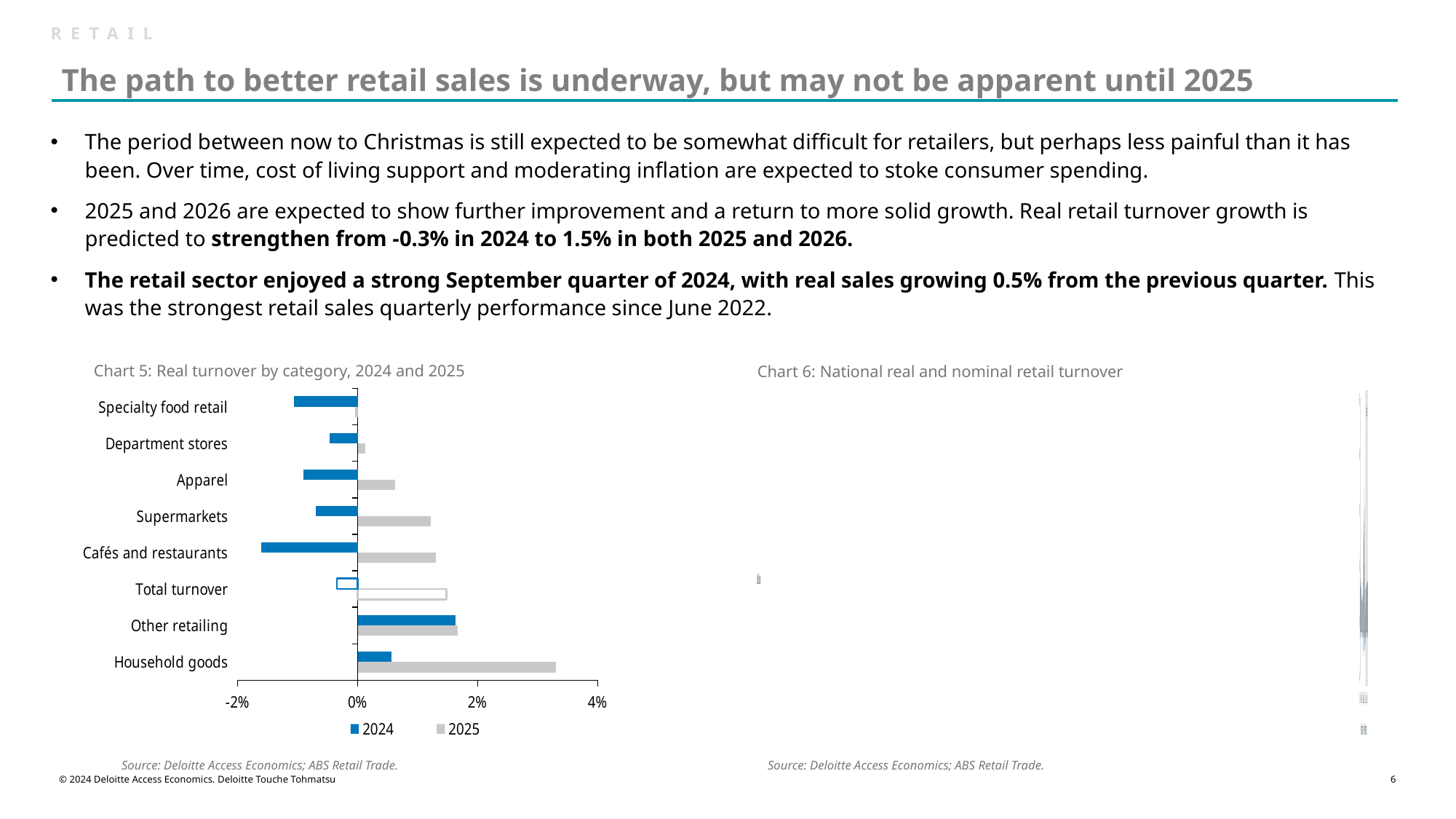
What kind of chart is Chart 5: Real turnover by category, 2024 and 2025? Bar chart In Chart 5, is the 2024 value for Cafés and restaurants greater or less than 0%? less In Chart 5, is the 2025 value for Supermarkets greater or less than 2%? less In Chart 5, which category has the lowest 2024 value? Cafés and restaurants In Chart 5, which category has the highest 2024 value? Other retailing How many categories are shown on the y axis of Chart 5? 8 In Chart 5, which colour represents the 2024 series in the legend? Blue How many series does the legend of Chart 5 list? 2 In Chart 5, which is larger: the 2025 value for Household goods or the 2025 value for Other retailing? Household goods In Chart 5, is the 2025 value for Household goods greater or less than 2%? greater In Chart 5, which category has the highest 2025 value? Household goods In Chart 5, which is larger: the 2024 value for Apparel or the 2024 value for Cafés and restaurants? Apparel